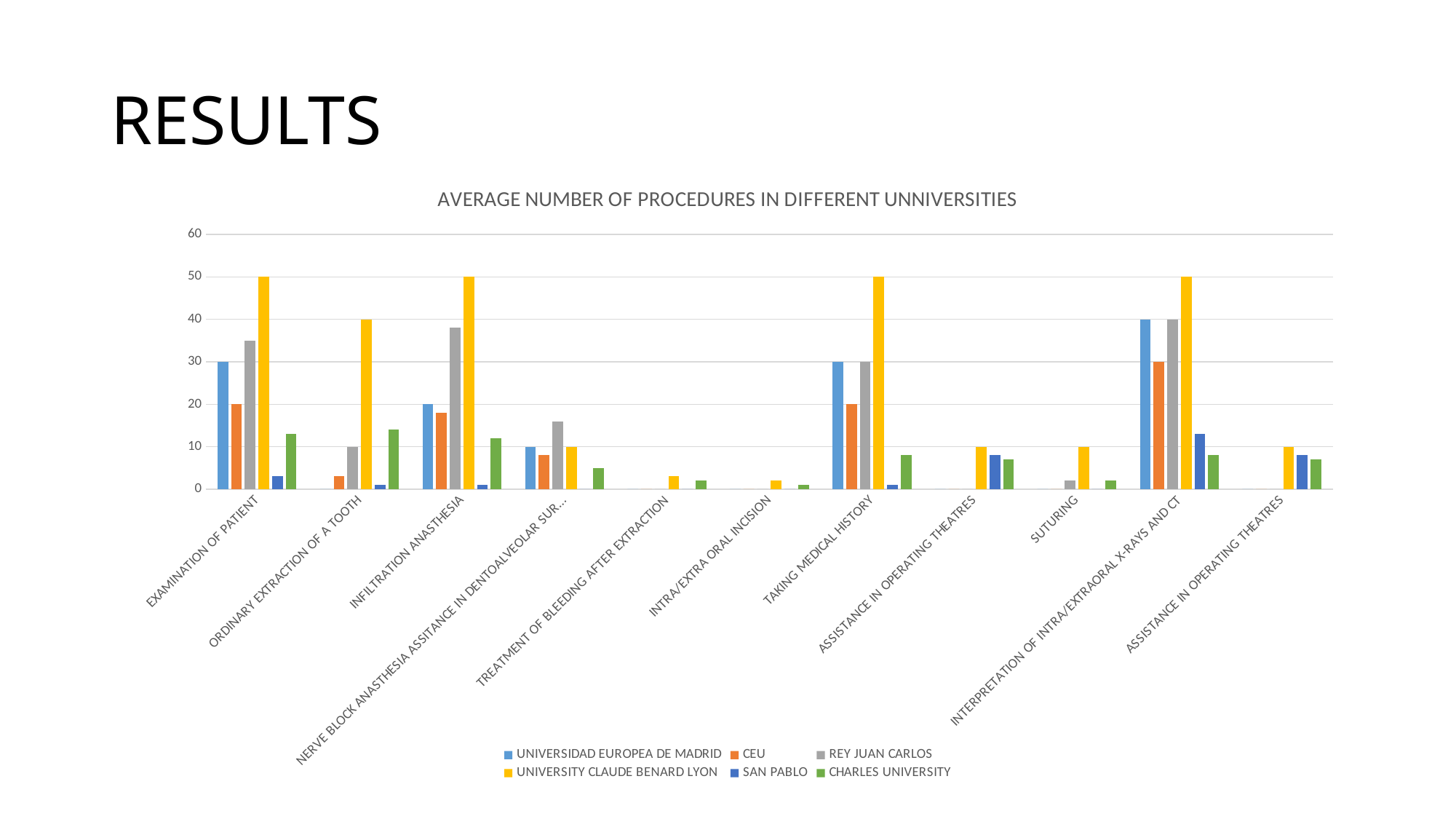
What is the value for University Claude Benard Lyon for Ordinary Extraction of a Tooth? 40 What is the value for University Claude Benard Lyon for Examination of Patient? 50 Is the value for Rey Juan Carlos for Examination of Patient greater or less than 30? greater For Examination of Patient, which is larger: Universidad Europea de Madrid or CEU? Universidad Europea de Madrid How many series does the legend list? 6 What kind of chart is shown on the slide? bar chart Which university has the lowest value for Examination of Patient? San Pablo Which university has the highest value for Examination of Patient? University Claude Benard Lyon What is the value for Universidad Europea de Madrid for Taking Medical History? 30 How many procedure categories are shown on the x axis? 11 What is the title of the chart? AVERAGE NUMBER OF PROCEDURES IN DIFFERENT UNNIVERSITIES What is the difference between University Claude Benard Lyon and Universidad Europea de Madrid for Examination of Patient? 20